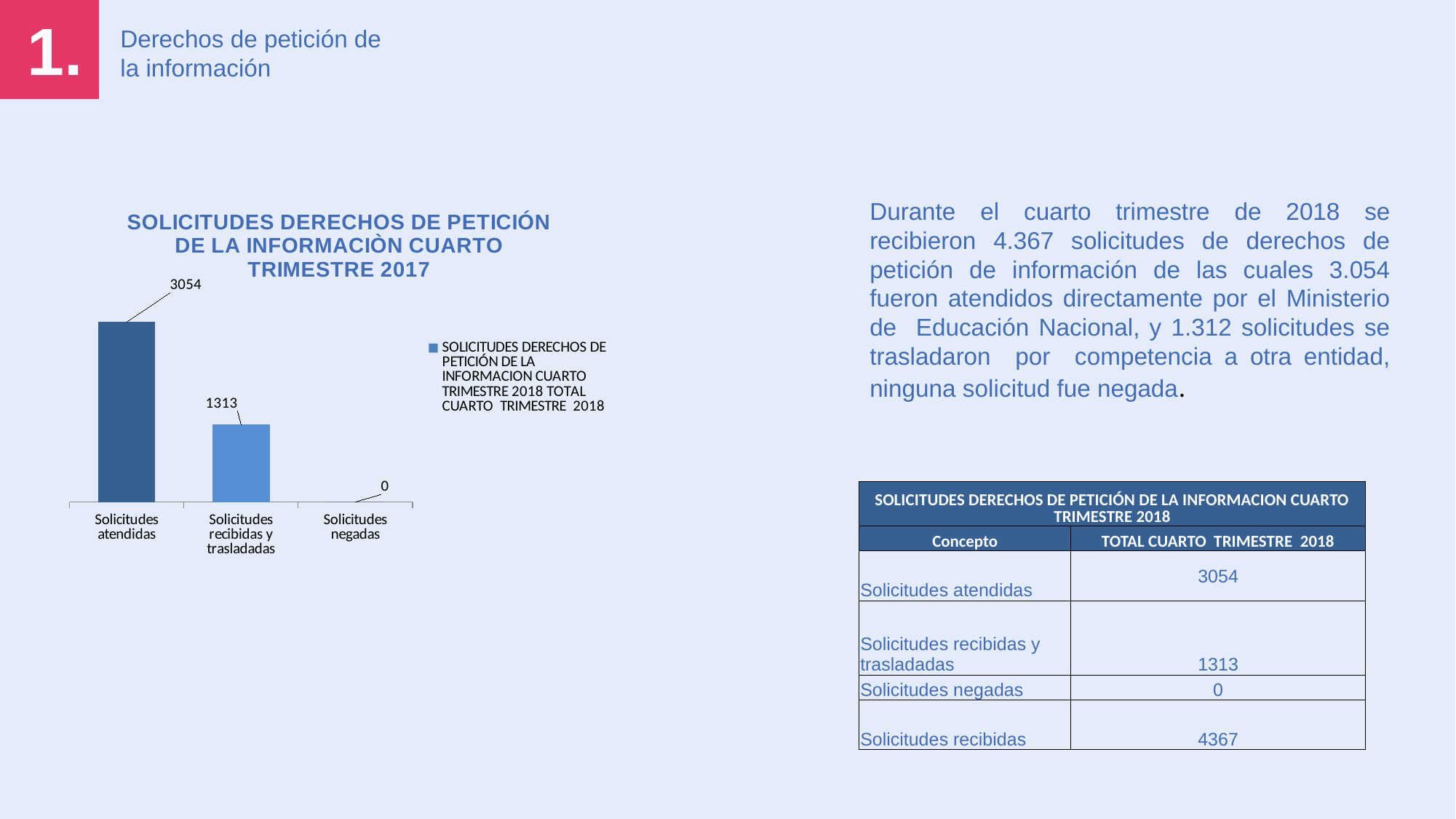
What is the value for Solicitudes negadas? 0 How many categories are shown on the x axis of the chart? 3 What is the title of the chart? SOLICITUDES DERECHOS DE PETICIÓN DE LA INFORMACIÒN CUARTO TRIMESTRE 2017 Which category has the highest value? Solicitudes atendidas Do the values rise or fall from left to right along the x axis? Fall What is the value for Solicitudes atendidas? 3054 Which category has the lowest value? Solicitudes negadas What is the value for Solicitudes recibidas y trasladadas? 1313 What kind of chart is shown on the slide? Bar chart Which is larger, Solicitudes atendidas or Solicitudes recibidas y trasladadas? Solicitudes atendidas What is the difference between Solicitudes atendidas and Solicitudes recibidas y trasladadas? 1741 How many series does the legend list? 1